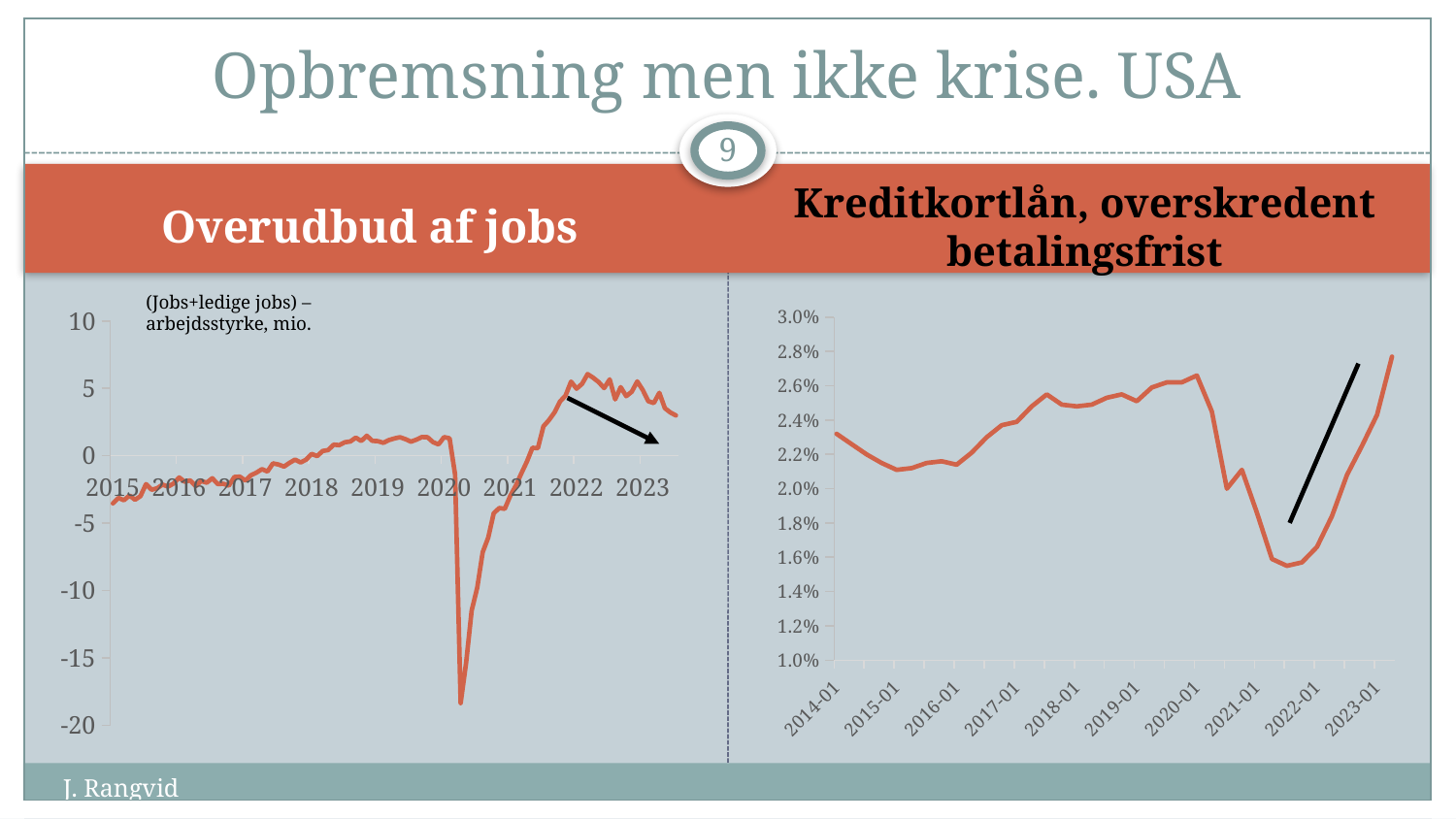
In the right chart "Kreditkortlån, overskredent betalingsfrist", does the line rise or fall between 2022-01 and 2023-01? rise In the right chart "Kreditkortlån, overskredent betalingsfrist", is the lowest value of the line greater or less than 1.8%? less In the left chart "Overudbud af jobs", in which year does the line reach its lowest point? 2020 In the left chart "Overudbud af jobs", is the peak value of the line around 2022 greater or less than 5? greater What kind of chart is the left chart titled "Overudbud af jobs"? line chart What kind of chart is the right chart titled "Kreditkortlån, overskredent betalingsfrist"? line chart In the left chart "Overudbud af jobs", does the line generally rise or fall between 2015 and 2019? rise What is the axis label text shown at the top of the left chart "Overudbud af jobs"? (Jobs+ledige jobs) – arbejdsstyrke, mio. In the right chart "Kreditkortlån, overskredent betalingsfrist", is the value at the end of the line (2023) greater or less than 2.6%? greater In the right chart "Kreditkortlån, overskredent betalingsfrist", does the line rise or fall between 2020-01 and 2021-01? fall